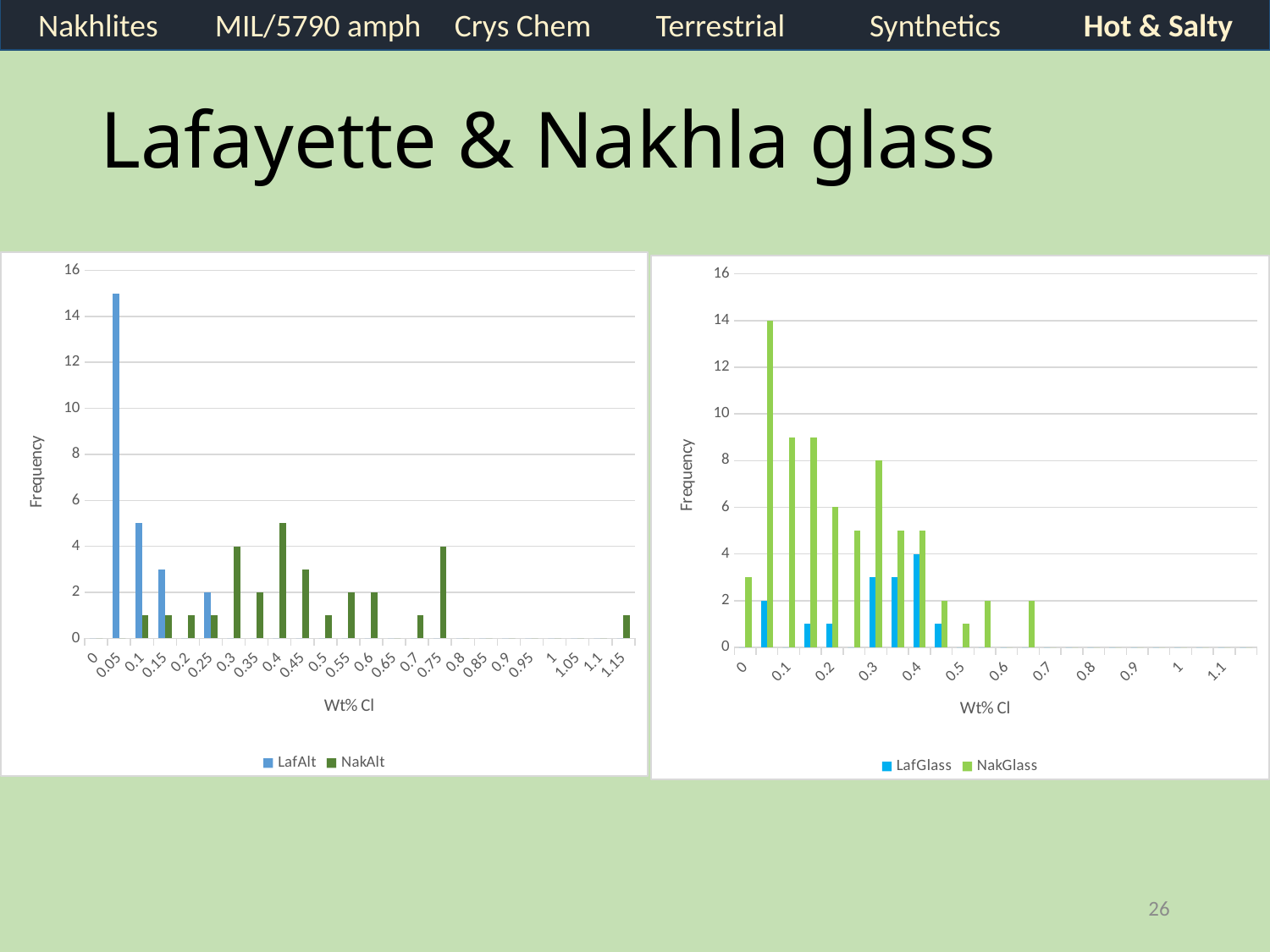
What kind of chart is the left chart? bar chart How many series does the legend of the right chart list? 2 How many series does the legend of the left chart list? 2 In the left chart, what is the NakAlt frequency at 0.75 Wt% Cl? 4 What is the x-axis title of the right chart? Wt% Cl In the left chart, is the LafAlt value at 0.05 Wt% Cl greater or less than 14? greater In the right chart, is the tallest NakGlass bar greater or less than 12? greater In the left chart, at 0.1 Wt% Cl, which series has the larger frequency, LafAlt or NakAlt? LafAlt In the right chart, which series has the tallest bar? NakGlass In the left chart, what is the NakAlt frequency at 0.3 Wt% Cl? 4 In the left chart, which series has the tallest bar? LafAlt In the right chart, what is the LafGlass frequency at 0.4 Wt% Cl? 4